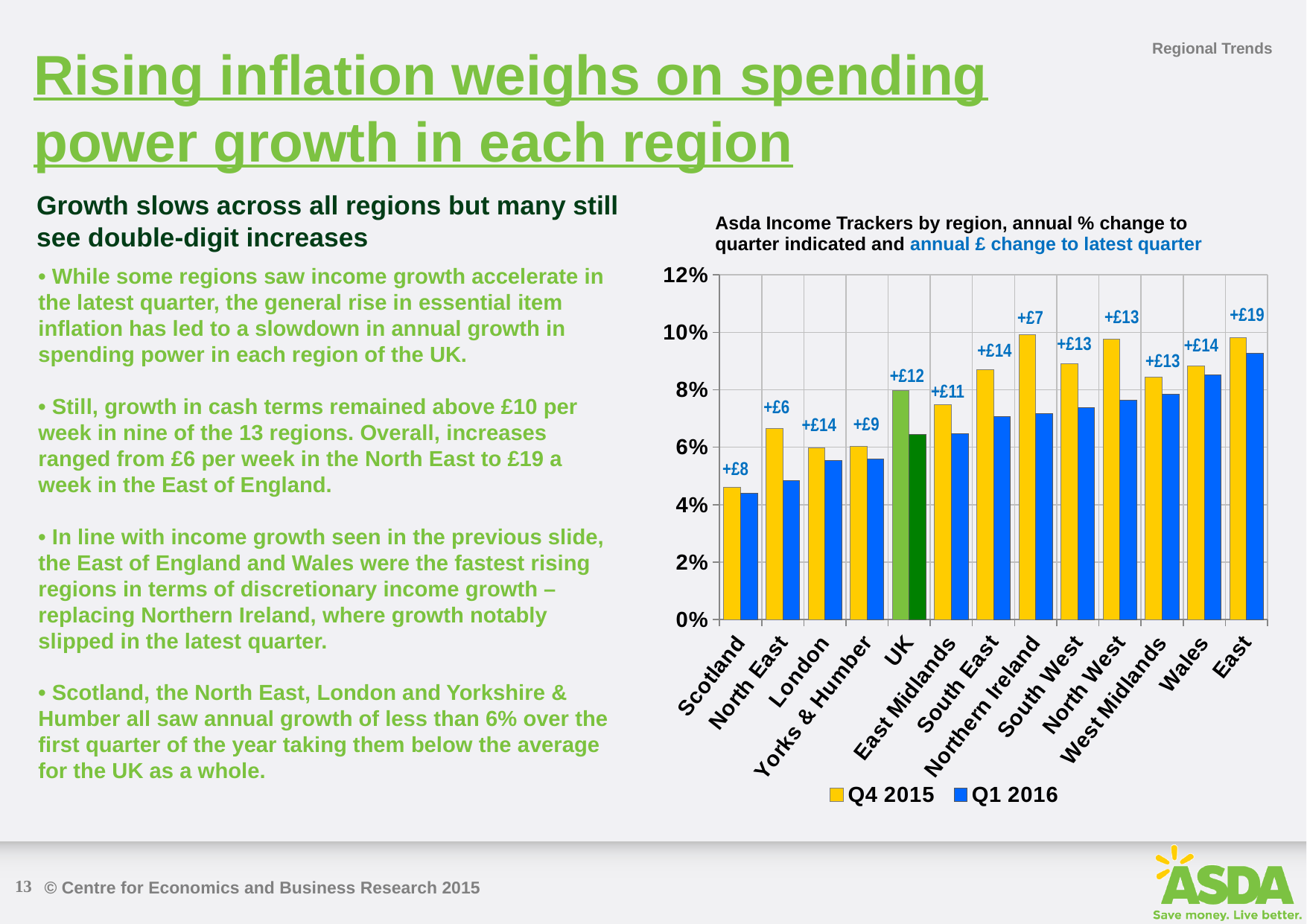
Is the Q1 2016 value for Scotland greater or less than 6%? less How many regions (categories) are shown on the x axis of the chart? 13 What annual £ change is labelled for the North East? +£6 Is the Q4 2015 value for Northern Ireland greater or less than 8%? greater What annual £ change is labelled for the UK? +£12 What annual £ change is labelled for East? +£19 How many series does the chart legend list? 2 For Northern Ireland, which is larger: the Q4 2015 bar or the Q1 2016 bar? Q4 2015 What is the difference between the labelled £ change for East and for the North East? £13 Which region has the highest labelled annual £ change? East What kind of chart is shown on the slide? Bar chart Which region has the lowest labelled annual £ change? North East